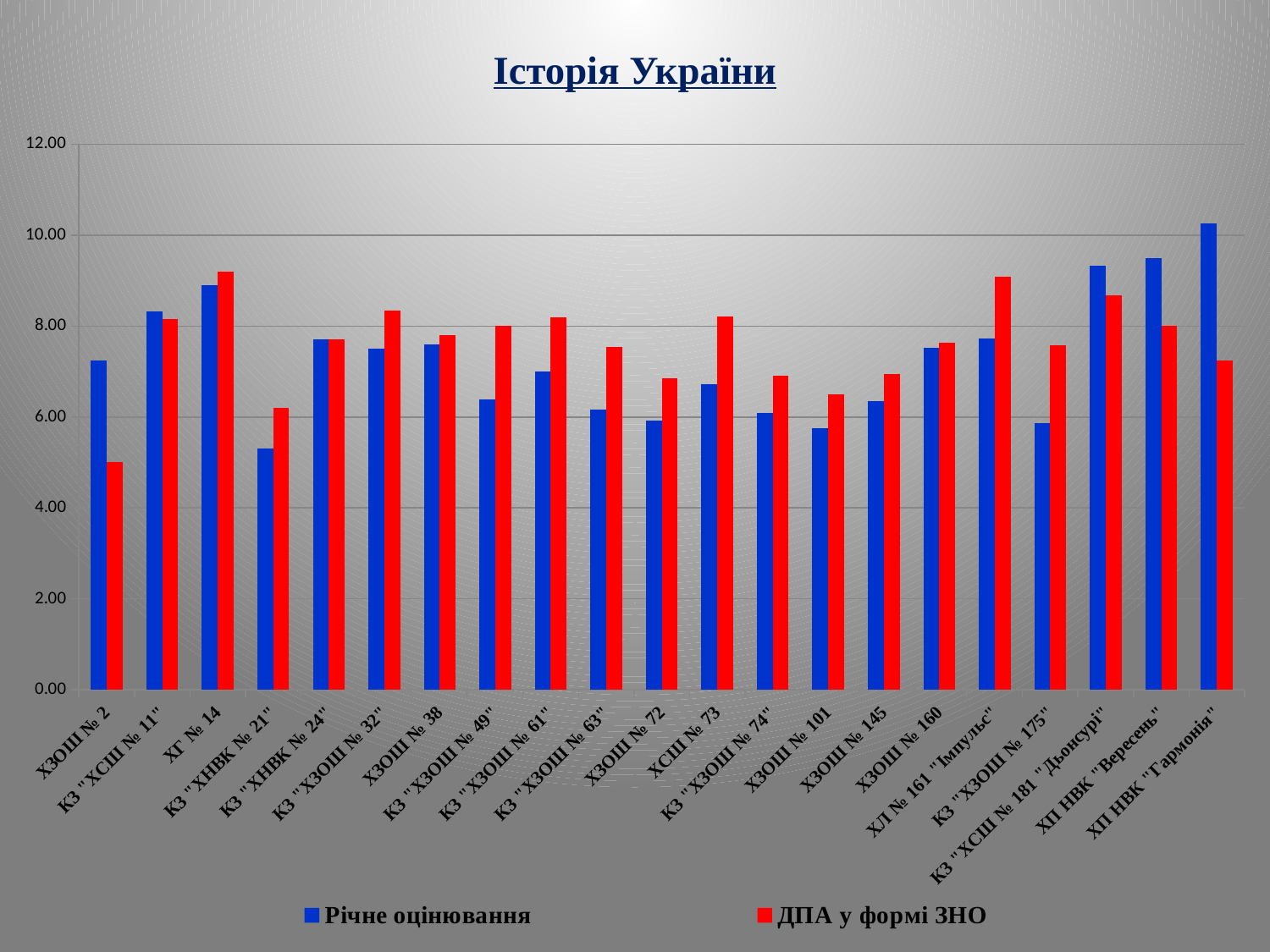
Is the Річне оцінювання value for ХП НВК "Гармонія" greater or less than 10.00? greater How many series does the legend list? 2 What is the title of the chart? Історія України Which school has the lowest value for Річне оцінювання? КЗ "ХНВК № 21" What kind of chart is shown on the slide? bar chart For ХЗОШ № 2, which is larger: Річне оцінювання or ДПА у формі ЗНО? Річне оцінювання Which school has the highest value for Річне оцінювання? ХП НВК "Гармонія" How many schools (categories) are shown on the x axis? 21 Is the ДПА у формі ЗНО value for ХЗОШ № 2 greater or less than 6.00? less For ХСШ № 73, which is larger: Річне оцінювання or ДПА у формі ЗНО? ДПА у формі ЗНО Is the ДПА у формі ЗНО value for ХЛ № 161 "Імпульс" greater or less than 8.00? greater Which school has the lowest value for ДПА у формі ЗНО? ХЗОШ № 2